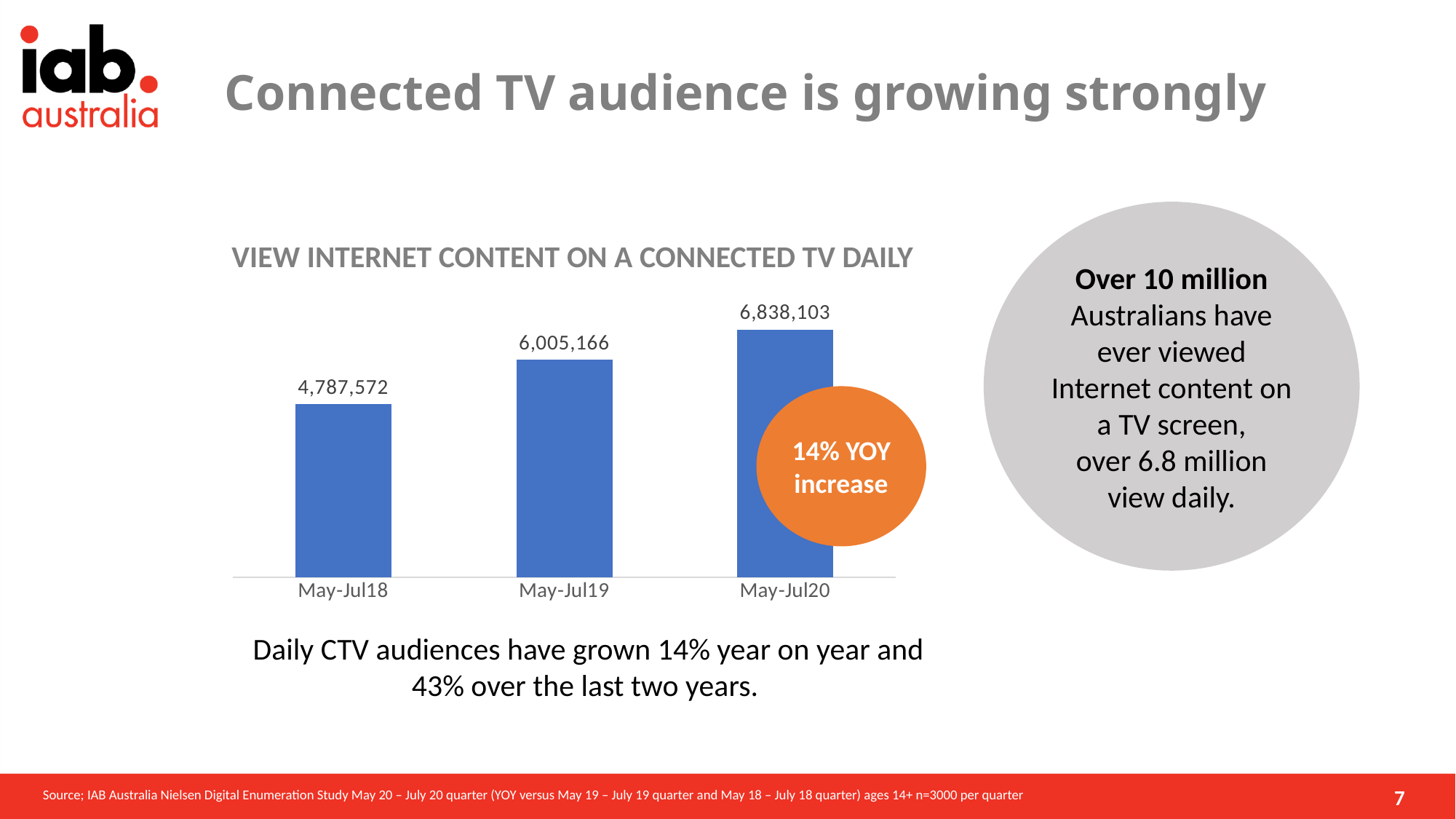
Do the values rise or fall from May-Jul18 to May-Jul20? Rise What is the value for May-Jul20 in the chart? 6,838,103 Which period has the lowest value in the chart? May-Jul18 What is the value for May-Jul18 in the chart? 4,787,572 How many periods are shown in the chart? 3 What kind of chart is shown on the slide? Bar chart What is the difference between the values for May-Jul20 and May-Jul18? 2,050,531 Which period has the highest value in the chart? May-Jul20 What is the difference between the values for May-Jul19 and May-Jul18? 1,217,594 What is the difference between the values for May-Jul20 and May-Jul19? 832,937 What is the value for May-Jul19 in the chart? 6,005,166 Which is larger, the value for May-Jul19 or the value for May-Jul18? May-Jul19